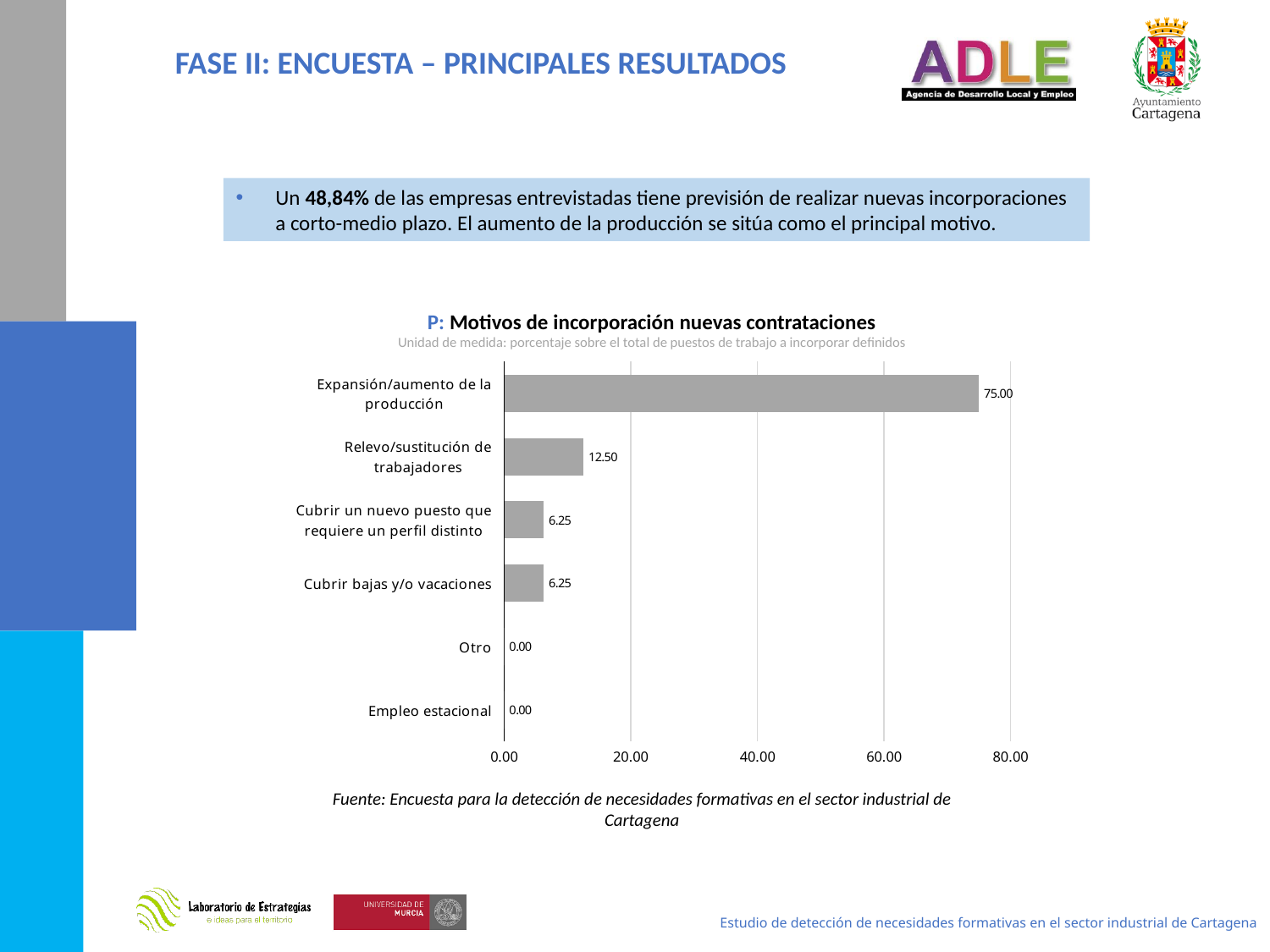
What is the value for Expansión/aumento de la producción? 75.00 What is the value for Empleo estacional? 0.00 What is the difference between the values for Expansión/aumento de la producción and Relevo/sustitución de trabajadores? 62.50 What is the value for Relevo/sustitución de trabajadores? 12.50 What is the difference between the values for Relevo/sustitución de trabajadores and Cubrir un nuevo puesto que requiere un perfil distinto? 6.25 Is the value for Expansión/aumento de la producción greater or less than 60.00? greater What is the value for Cubrir bajas y/o vacaciones? 6.25 How many categories are shown in the chart? 6 Which is larger, the value for Relevo/sustitución de trabajadores or the value for Cubrir bajas y/o vacaciones? Relevo/sustitución de trabajadores Which category has the highest value? Expansión/aumento de la producción What kind of chart is shown on the slide? bar chart What is the title of the chart? P: Motivos de incorporación nuevas contrataciones